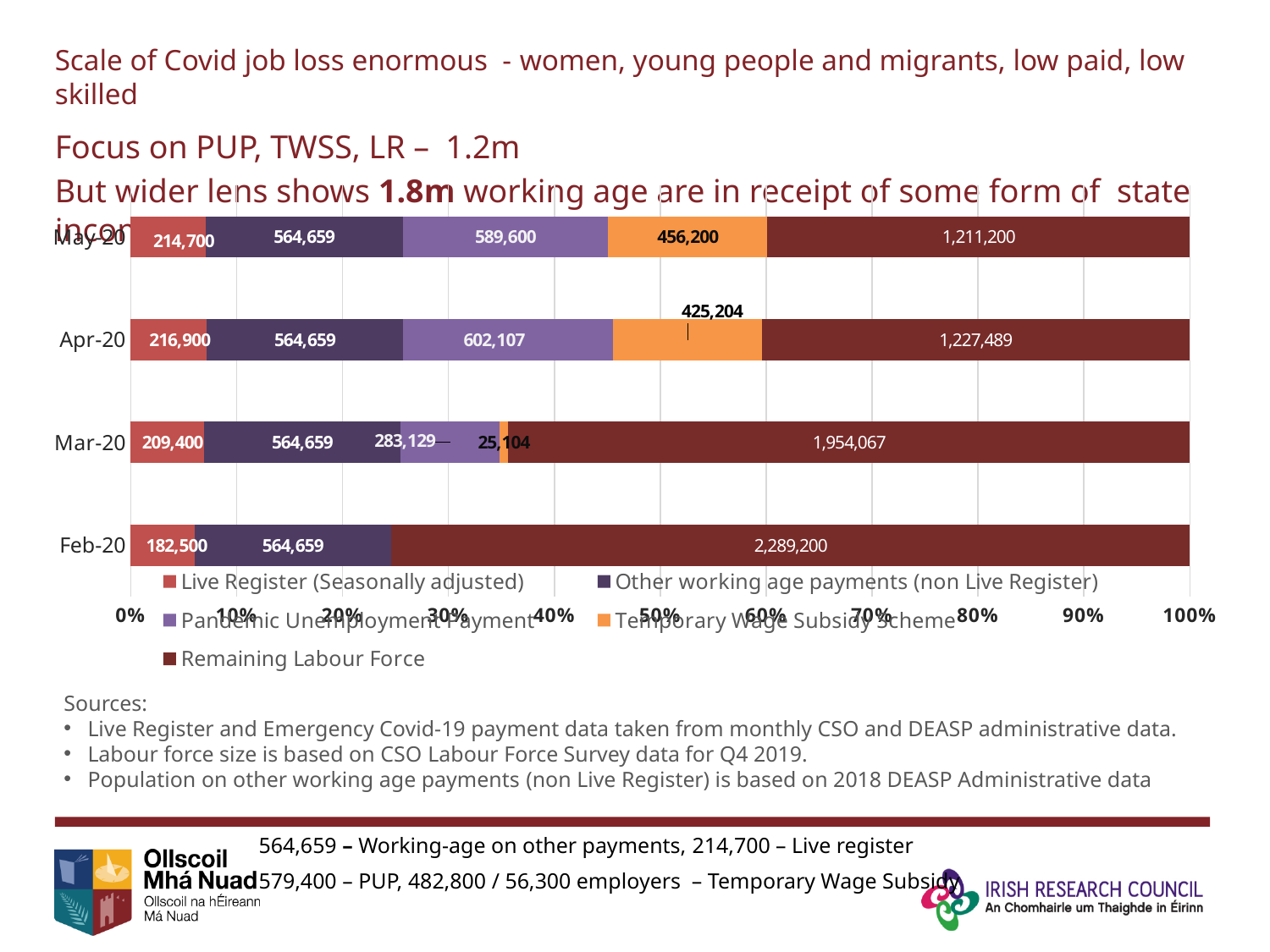
What is the total of the stacked bar for Feb-20? 3,036,359 In which month is the Live Register (Seasonally adjusted) value highest? Apr-20 In which month is the Remaining Labour Force value lowest? May-20 How many months (categories) are plotted in the chart? 4 What is the Remaining Labour Force value for Feb-20? 2,289,200 What is the value of the Temporary Wage Subsidy Scheme segment for Mar-20? 25,104 What type of chart is shown on the slide? Stacked bar chart What is the difference between the Pandemic Unemployment Payment values for Apr-20 and Mar-20? 318,978 What is the value of the Pandemic Unemployment Payment segment for Apr-20? 602,107 Does the Remaining Labour Force value rise or fall from Feb-20 to May-20? Fall Which is larger: the Temporary Wage Subsidy Scheme value for May-20 or for Apr-20? May-20 How many series does the chart legend list? 5